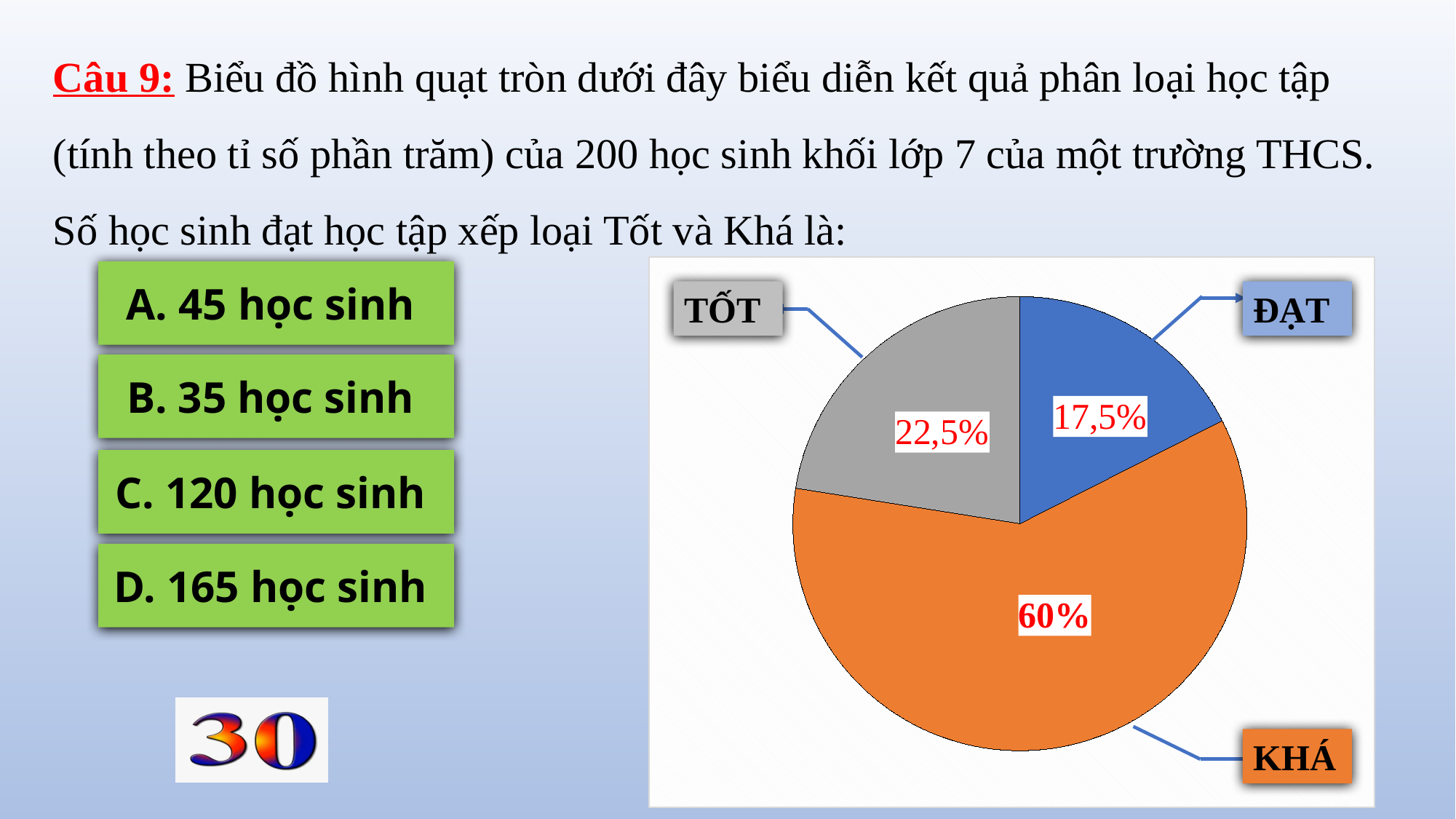
Which category has the smallest slice of the pie? ĐẠT What kind of chart is shown on the slide? pie chart What colour is the ĐẠT slice of the pie chart? blue What percentage does the KHÁ slice show? 60% What colour is the KHÁ slice of the pie chart? orange What is the difference in percentage points between the KHÁ slice and the TỐT slice? 37,5% What percentage does the TỐT slice show? 22,5% How many slices does the pie chart have? 3 Which category has the largest slice of the pie? KHÁ What is the difference in percentage points between the TỐT slice and the ĐẠT slice? 5% What percentage does the ĐẠT slice show? 17,5% Which slice is larger, TỐT or ĐẠT? TỐT